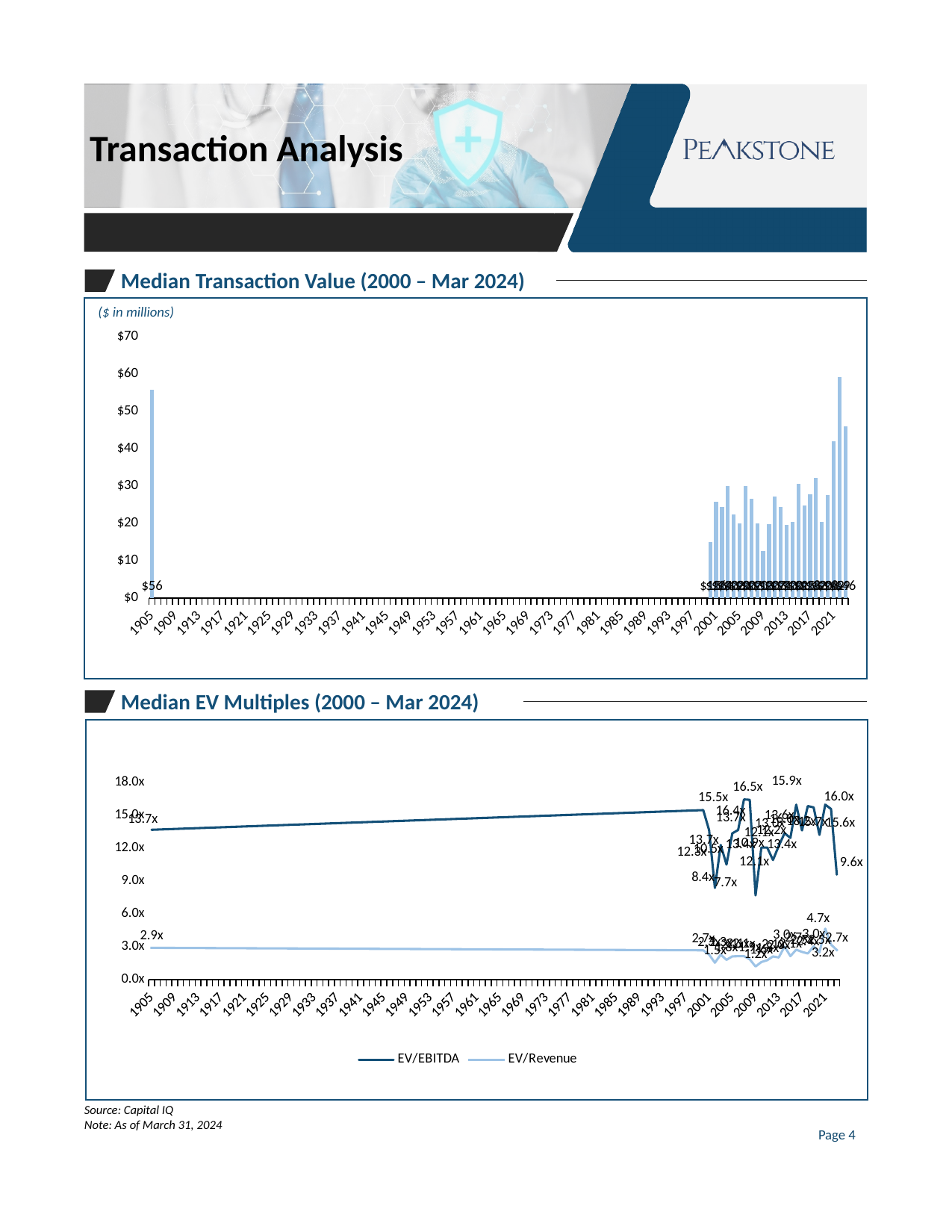
In the Median Transaction Value chart, what is the labeled value of the first bar at 1905? $56 What unit note is shown at the top left of the Median Transaction Value chart? ($ in millions) In the Median EV Multiples chart, what is the labeled EV/EBITDA value at the first point (1905)? 13.7x In the Median EV Multiples chart, what is the labeled EV/EBITDA value at the last point on the right? 9.6x In the Median EV Multiples chart, what is the highest labeled EV/Revenue value? 4.7x What kind of chart is the Median EV Multiples (2000 – Mar 2024) chart? line chart What kind of chart is the Median Transaction Value (2000 – Mar 2024) chart? bar chart How many series does the legend of the Median EV Multiples chart list? 2 In the Median Transaction Value chart, is the tallest bar near the right end of the chart greater or less than $50? greater In the Median EV Multiples chart, what is the labeled EV/Revenue value at the first point (1905)? 2.9x What are the two series named in the legend of the Median EV Multiples chart? EV/EBITDA and EV/Revenue In the Median EV Multiples chart, which series has higher values throughout, EV/EBITDA or EV/Revenue? EV/EBITDA